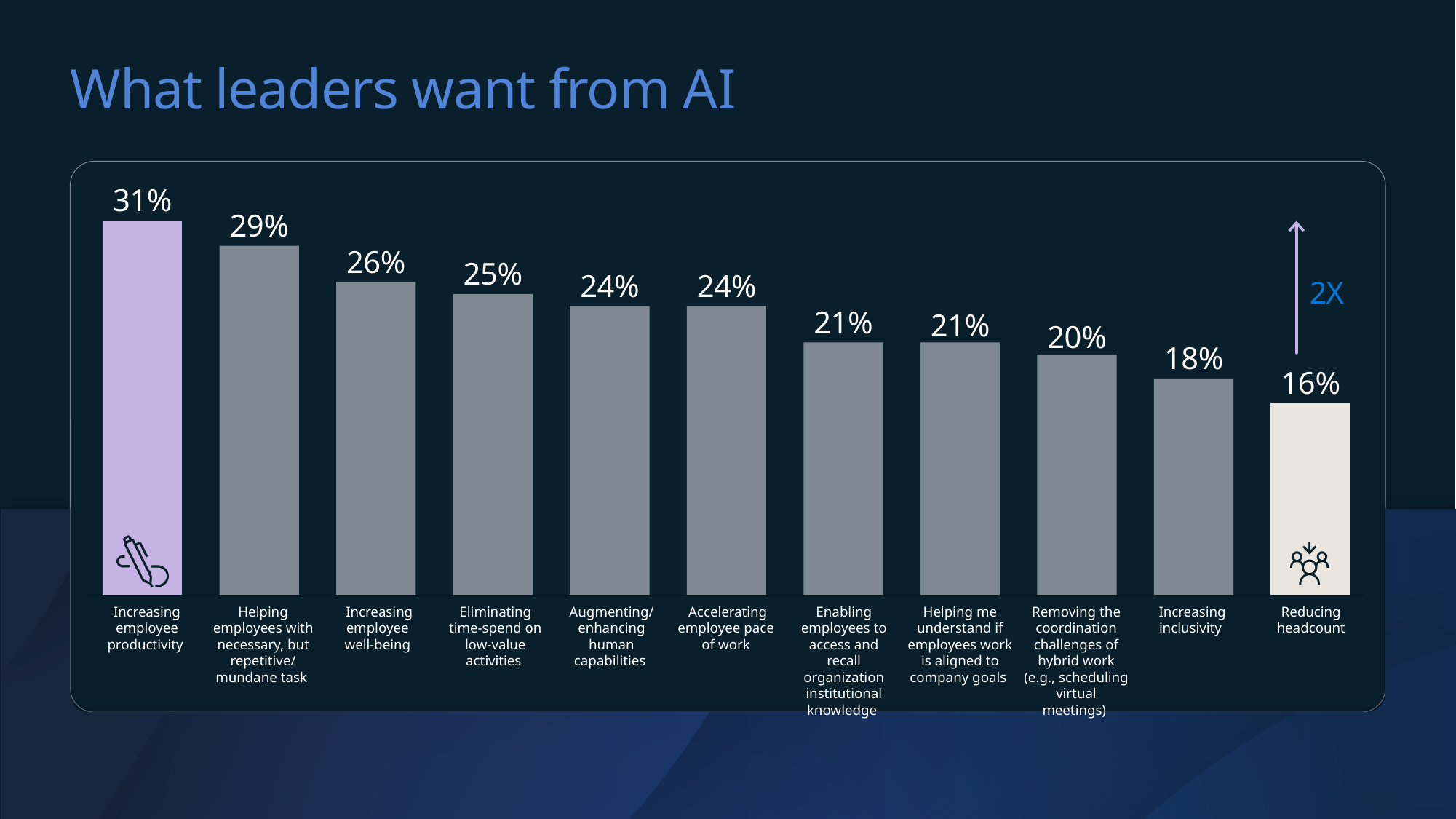
Which category has the lowest value? Reducing headcount Which category has the highest value? Increasing employee productivity What is the value for Increasing inclusivity? 18% What is the title of the slide? What leaders want from AI What is the value for Increasing employee productivity? 31% What is the value for Reducing headcount? 16% What is the value for Eliminating time-spend on low-value activities? 25% How many categories are shown in the chart? 11 What kind of chart is shown on the slide? Bar chart What is the difference between the values for Increasing employee productivity and Reducing headcount? 15% What is the difference between the values for Increasing employee well-being and Increasing inclusivity? 8% Which is larger, the value for Helping employees with necessary, but repetitive/mundane task or the value for Accelerating employee pace of work? Helping employees with necessary, but repetitive/mundane task